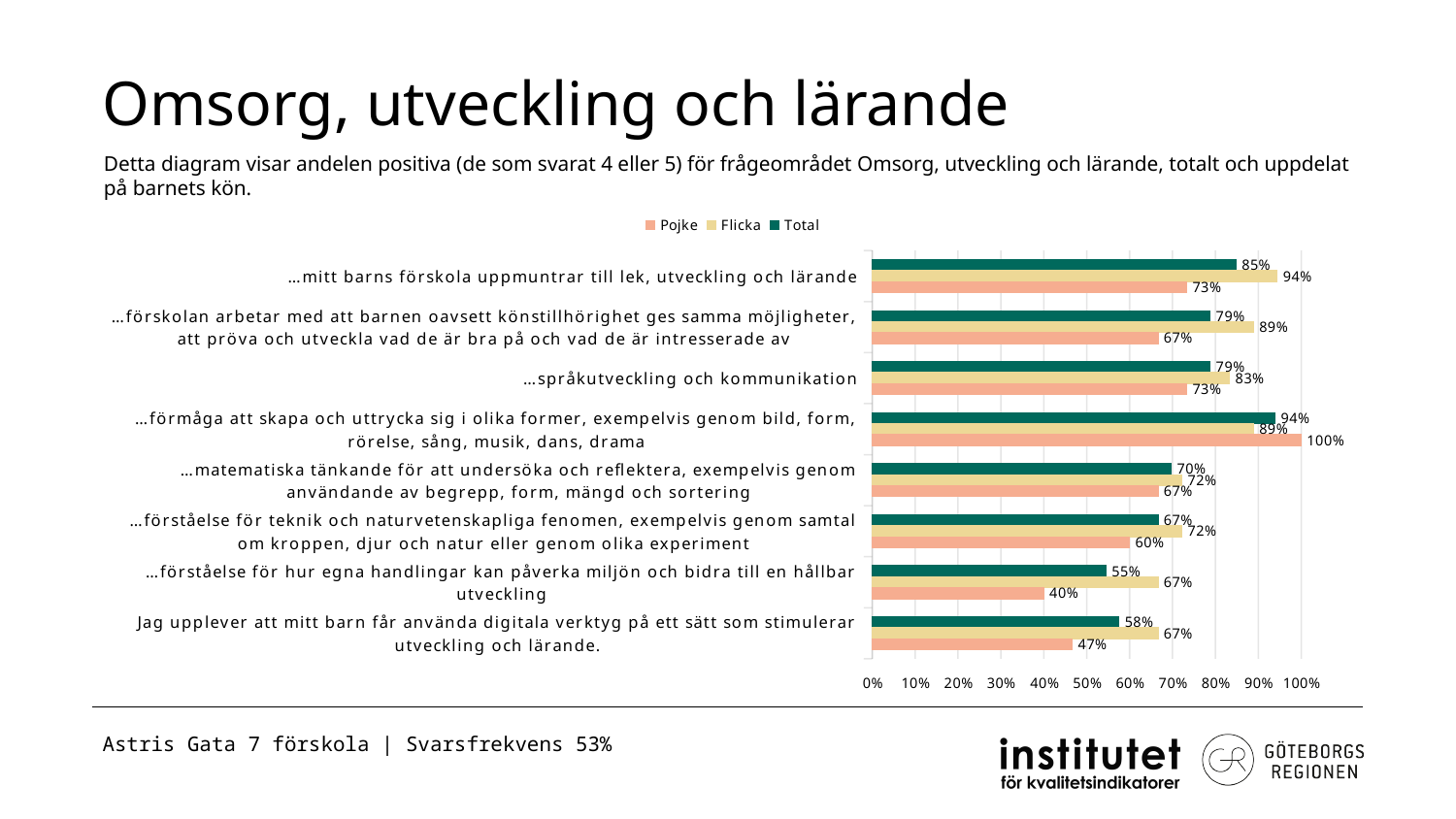
How many series does the legend list? 3 For "…förmåga att skapa och uttrycka sig i olika former", which is larger, the Pojke value or the Flicka value? Pojke What is the Total value for "…språkutveckling och kommunikation"? 79% What kind of chart is shown on the slide? Bar chart Which series is shown in green in the legend? Total How many categories (question statements) are shown in the chart? 8 Is the Pojke value for "Jag upplever att mitt barn får använda digitala verktyg på ett sätt som stimulerar utveckling och lärande." greater or less than 50%? less Which category has the lowest Pojke value? …förståelse för hur egna handlingar kan påverka miljön och bidra till en hållbar utveckling What is the difference between the Flicka and Pojke values for "…förskolan arbetar med att barnen oavsett könstillhörighet ges samma möjligheter, att pröva och utveckla vad de är bra på och vad de är intresserade av"? 22 percentage points What is the Pojke value for "…förståelse för hur egna handlingar kan påverka miljön och bidra till en hållbar utveckling"? 40% What is the Flicka value for "…mitt barns förskola uppmuntrar till lek, utveckling och lärande"? 94% Which category has the highest Total value? …förmåga att skapa och uttrycka sig i olika former, exempelvis genom bild, form, rörelse, sång, musik, dans, drama